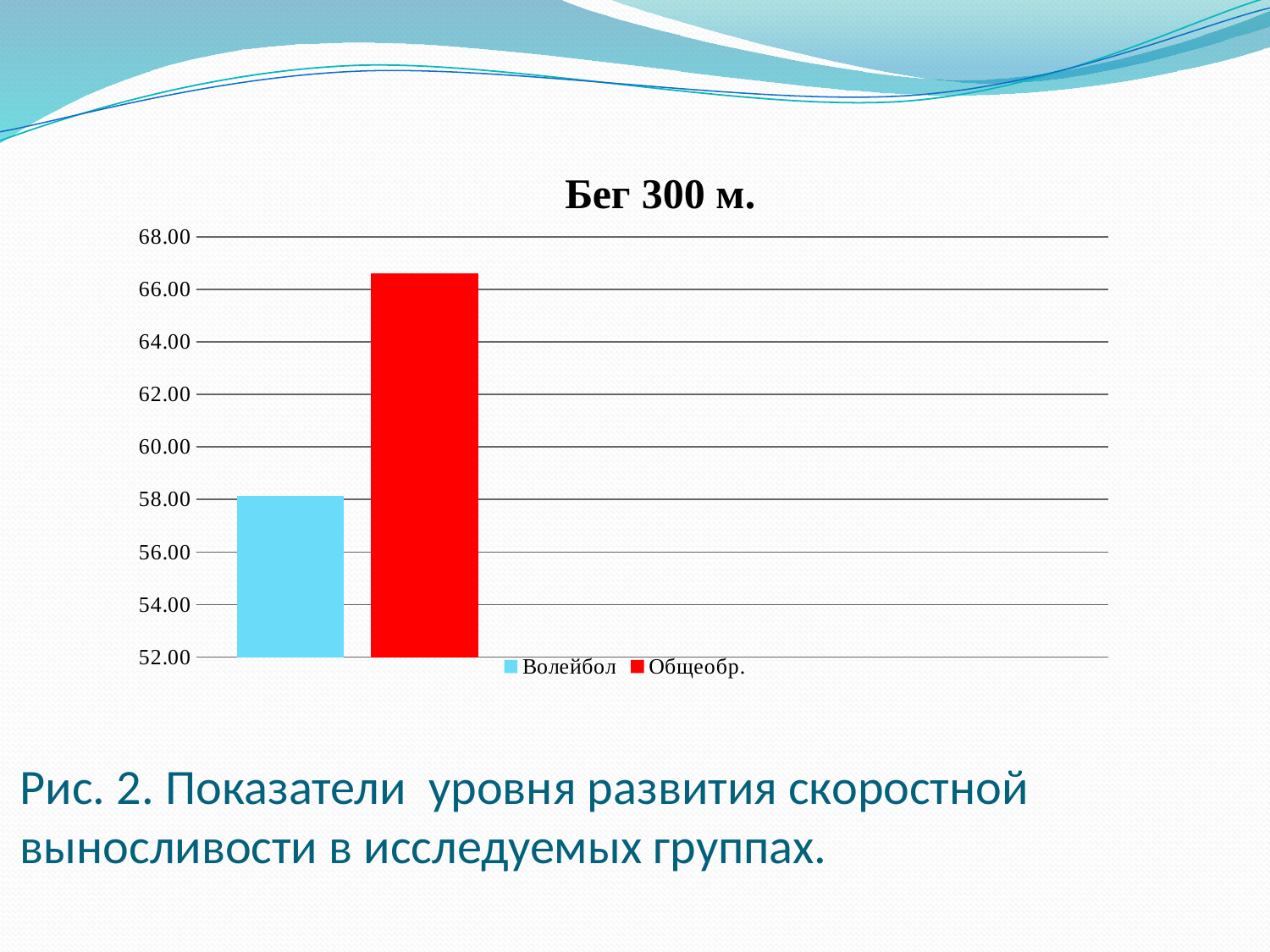
Which is larger, the value for Волейбол or the value for Общеобр.? Общеобр. What kind of chart is shown on the slide? bar chart Is the value for Волейбол greater or less than 56.00? greater Which series has the lowest value? Волейбол Is the value for Волейбол greater or less than 60.00? less Which series has the highest value? Общеобр. How many series does the legend list? 2 Is the value for Общеобр. greater or less than 66.00? greater What colour is the bar for Общеобр.? red How many bars are plotted on the chart? 2 What is the title of the chart? Бег 300 м.